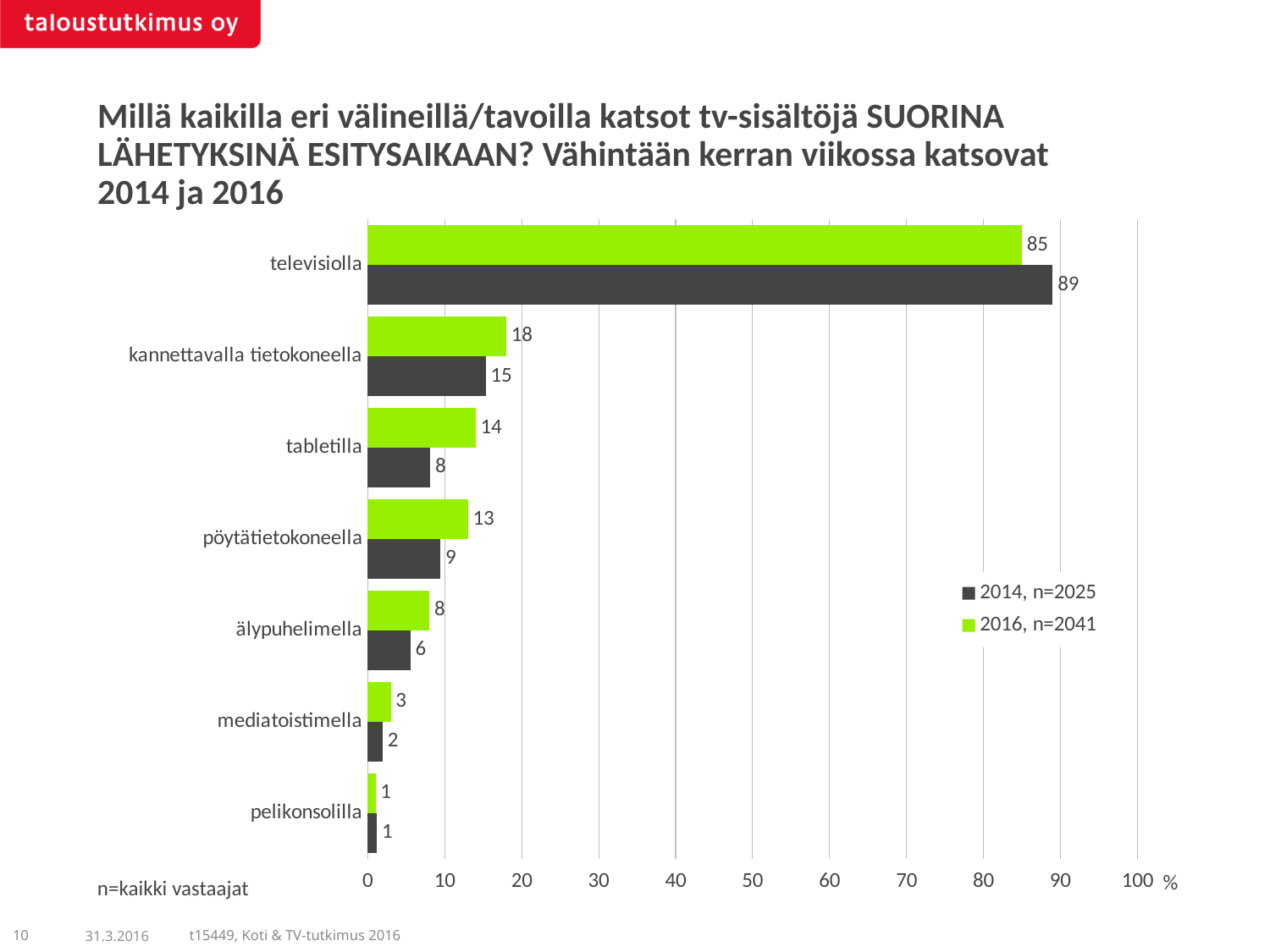
How many categories (viewing devices) are shown on the chart? 7 What sample size is given for the 2016 series in the legend? n=2041 Which category has the highest value in the 2016 series? televisiolla What is the difference between the 2016 and 2014 values for 'tabletilla'? 6 What is the difference between the 2014 and 2016 values for 'televisiolla'? 4 What is the value for 'älypuhelimella' in the 2014 series? 6 Which category has the lowest value in the 2014 series? pelikonsolilla For 'kannettavalla tietokoneella', which series has the larger value, 2014 or 2016? 2016 What is the value for 'televisiolla' in the 2014 series? 89 What kind of chart is shown on the slide? bar chart How many series does the legend list? 2 What is the value for 'tabletilla' in the 2016 series? 14